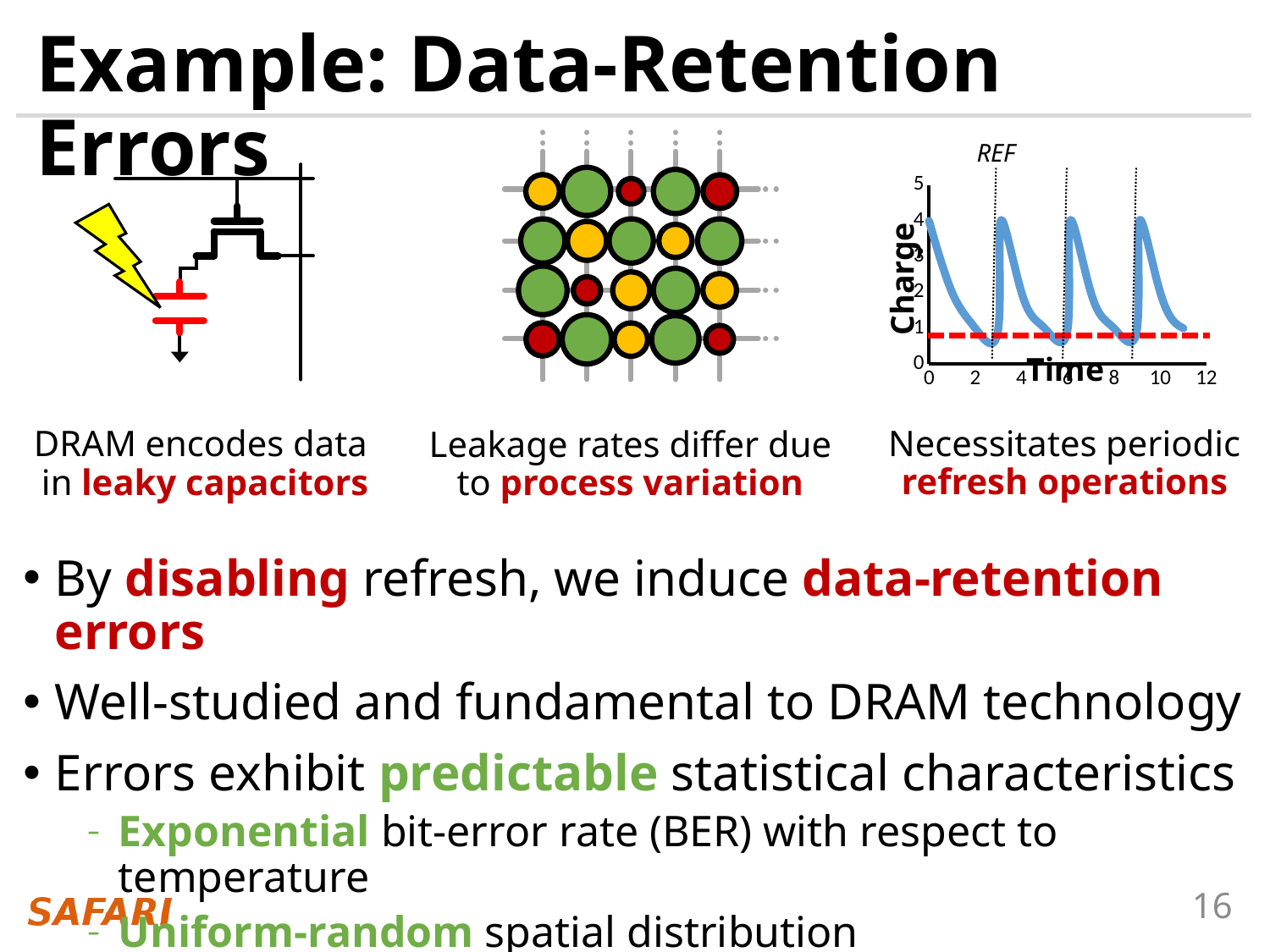
On the Charge vs Time chart, is the peak charge value greater or less than 3? greater What kind of chart is shown in the top-right of the slide? line chart On the Charge vs Time chart, what is the highest value shown on the y-axis? 5 On the Charge vs Time chart, what is the highest value shown on the x-axis? 12 How many vertical dotted REF lines are drawn on the Charge vs Time chart? 3 What is the label of the y-axis on the Charge vs Time chart? Charge On the Charge vs Time chart, is the peak charge value greater or less than 5? less On the Charge vs Time chart, does the charge rise or fall between consecutive refresh operations? fall What is the label of the x-axis on the Charge vs Time chart? Time How many charge peaks does the curve show on the Charge vs Time chart? 4